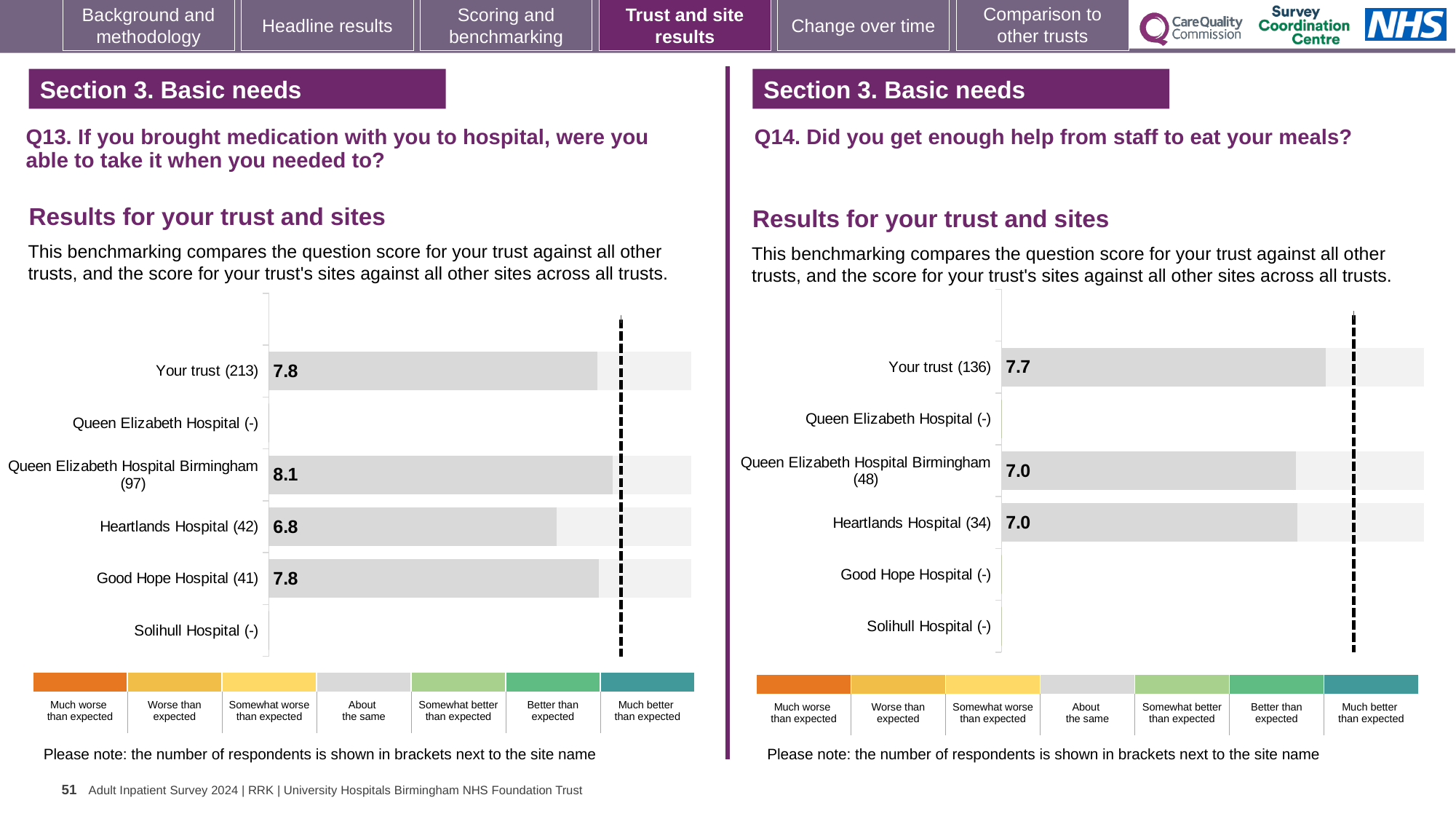
On the Q13 chart (left), what is the score for Heartlands Hospital? 6.8 On the Q14 chart (right), what is the score for Queen Elizabeth Hospital Birmingham? 7.0 On the Q13 chart (left), what is the difference between the scores for Queen Elizabeth Hospital Birmingham and Heartlands Hospital? 1.3 On the Q14 chart (right), how many site rows are listed on the vertical axis? 5 On the Q13 chart (left), which site has the highest score? Queen Elizabeth Hospital Birmingham On the Q14 chart (right), what is the difference between the scores for Your trust and Heartlands Hospital? 0.7 On the Q13 chart (left), how many sites have a score bar plotted? 3 On the Q13 chart (left), what is the score for Your trust? 7.8 On the Q14 chart (right), what is the score for Your trust? 7.7 What type of chart is used on the Q13 chart (left)? Bar chart On the Q14 chart (right), which is larger, the score for Your trust or the score for Heartlands Hospital? Your trust On the Q13 chart (left), which site has the lowest score? Heartlands Hospital